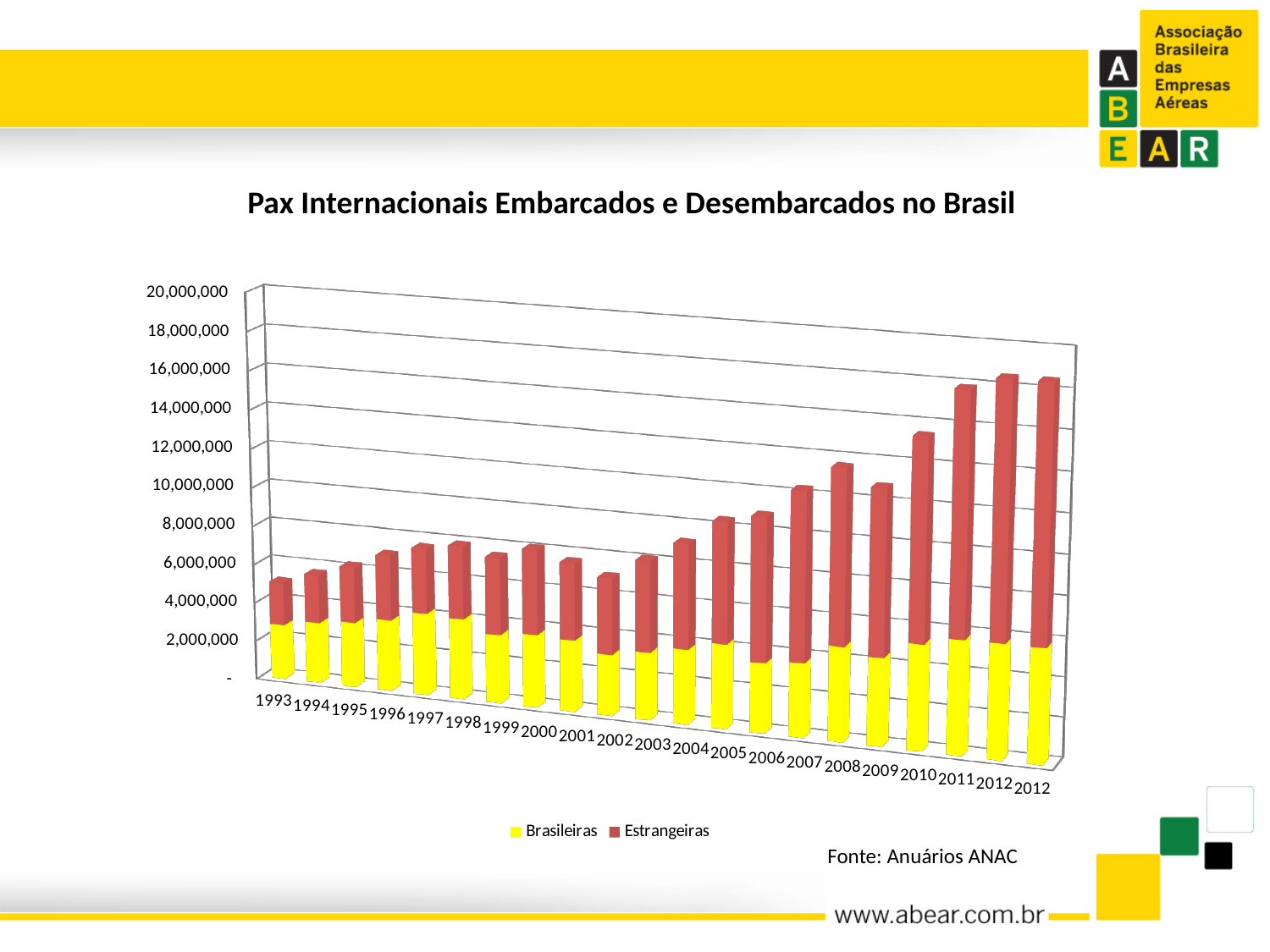
Which year has the larger total, 2008 or 2009? 2008 Is the total value for 1993 greater or less than 6,000,000? less Which year has the larger total, 1997 or 2002? 1997 Which series is shown in yellow? Brasileiras How many series does the legend list? 2 Which year has the larger total, 2010 or 2011? 2011 Is the total value for 2011 greater or less than 14,000,000? greater Is the total value for 2008 greater or less than 10,000,000? greater Do the total values generally rise or fall from 1993 to 2012? rise What kind of chart is shown on the slide? Stacked bar chart What is the title of the chart? Pax Internacionais Embarcados e Desembarcados no Brasil